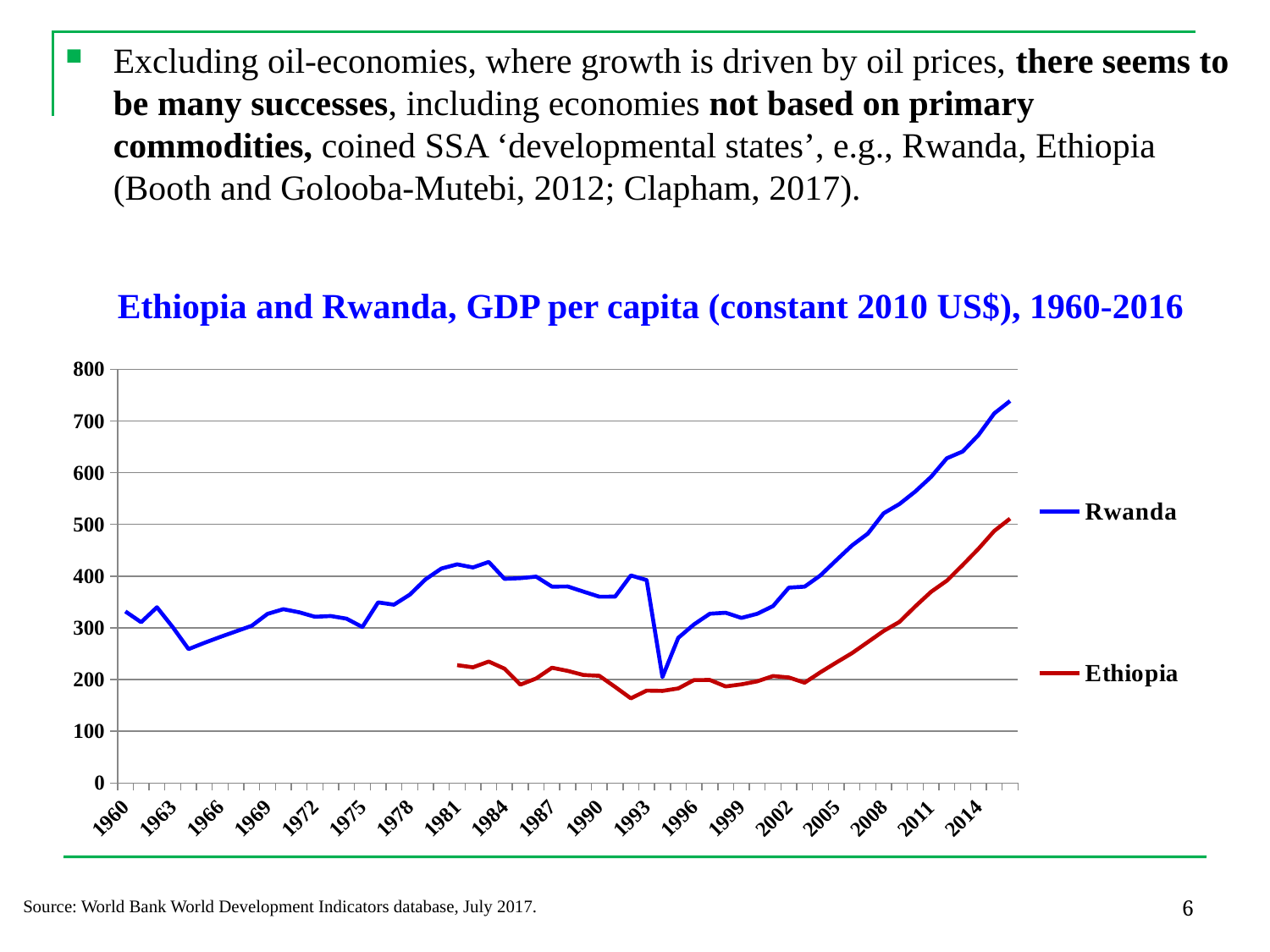
Is the value for Rwanda in 2016 greater or less than 700? greater Does the Ethiopia line rise or fall from 2003 to 2016? Rise Is the value for Ethiopia in 2016 greater or less than 400? greater Which colour is used for the Rwanda line? Blue Which series has the higher value in 2016, Rwanda or Ethiopia? Rwanda What kind of chart is shown on the slide? Line chart Is the value for Rwanda in 1965 greater or less than 300? less In which year does the Rwanda line reach its lowest point? 1994 How many series does the legend list? 2 What is the title of the chart? Ethiopia and Rwanda, GDP per capita (constant 2010 US$), 1960-2016